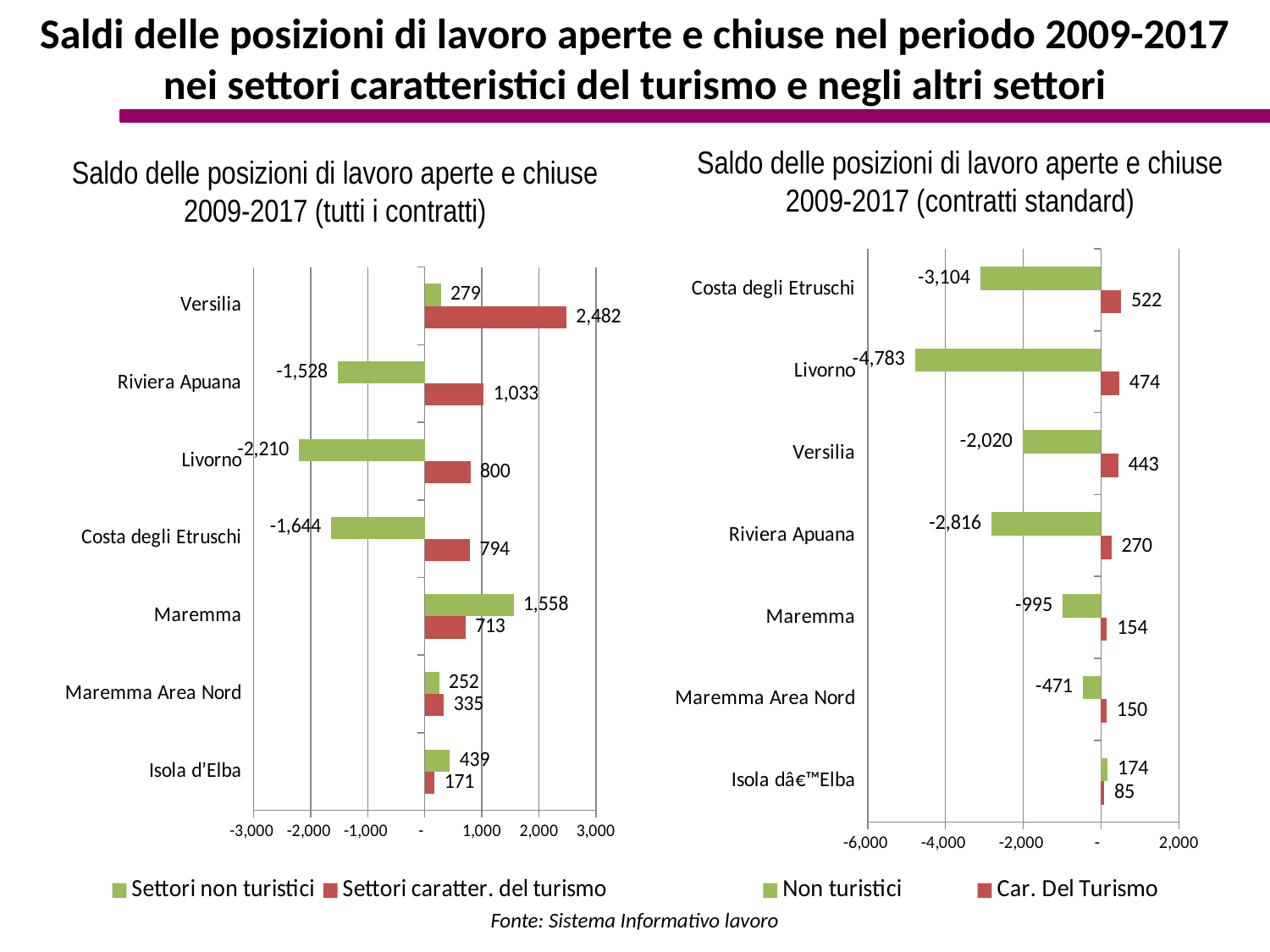
In the left chart (tutti i contratti), what is the value for Settori non turistici in Livorno? -2,210 What type of chart is the left chart (tutti i contratti)? Bar chart In the right chart (contratti standard), what is the value for Non turistici in Livorno? -4,783 In the left chart (tutti i contratti), what is the difference between the Settori non turistici value for Maremma and the Settori caratter. del turismo value for Maremma? 845 How many areas are shown in the left chart (tutti i contratti)? 7 In the left chart (tutti i contratti), which area has the highest value for Settori caratter. del turismo? Versilia How many series does the legend of the right chart (contratti standard) list? 2 In the right chart (contratti standard), which is larger: the Car. Del Turismo value for Versilia or for Riviera Apuana? Versilia In the left chart (tutti i contratti), what is the value for Settori caratter. del turismo in Versilia? 2,482 In the right chart (contratti standard), what is the value for Car. Del Turismo in Costa degli Etruschi? 522 In the right chart (contratti standard), what is the difference between the Car. Del Turismo value for Isola d'Elba and the Non turistici value for Isola d'Elba? 89 In the right chart (contratti standard), which area has the lowest value for Non turistici? Livorno